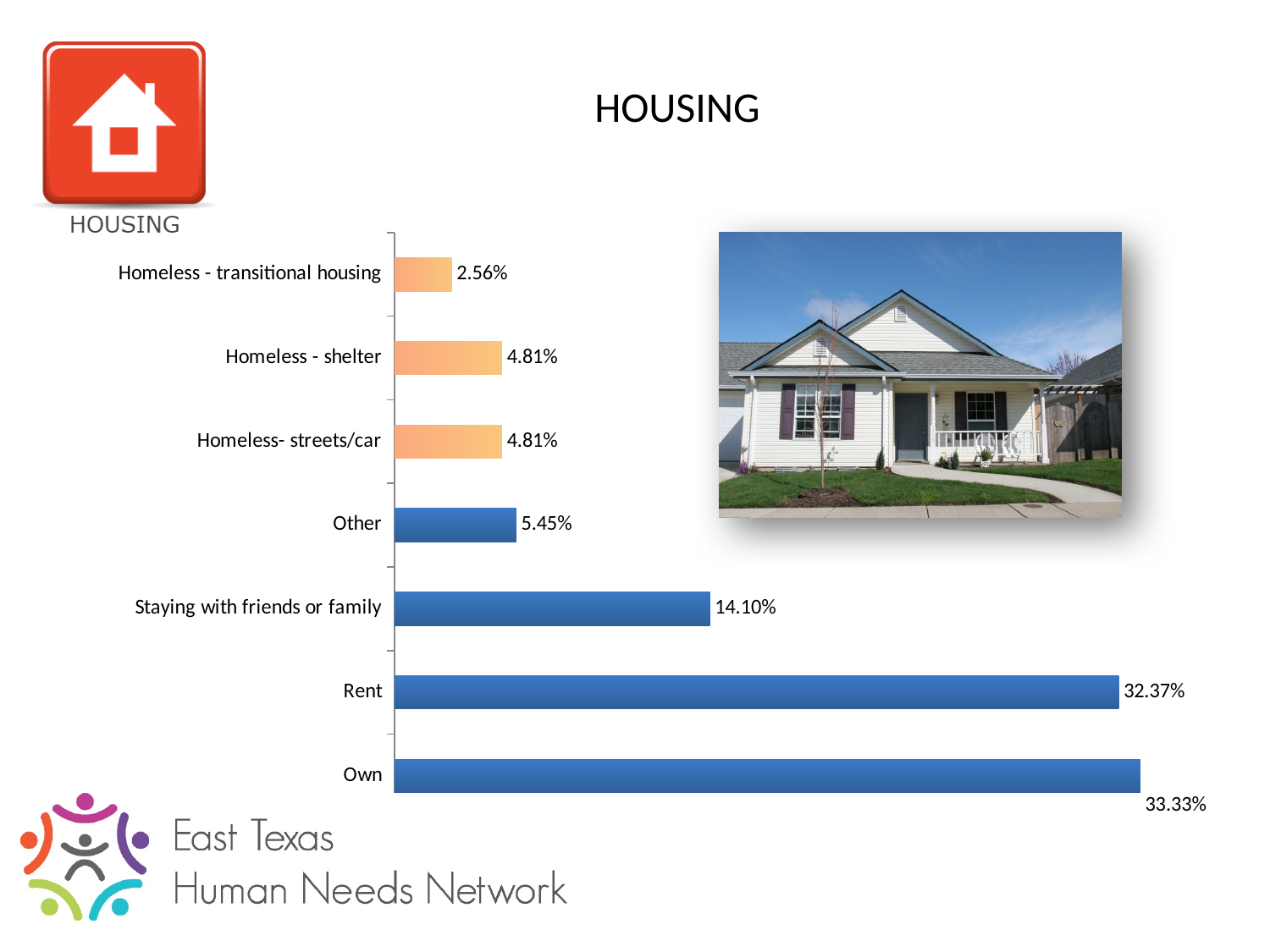
Which category has the lowest value? Homeless - transitional housing What is the value for Staying with friends or family? 14.10% Which category has the highest value? Own Which is larger, the value for Other or the value for Homeless - shelter? Other What percentage of respondents own their housing? 33.33% What is the value for Rent? 32.37% What is the difference between the values for Own and Rent? 0.96% What kind of chart is shown on the slide? Bar chart What is the title of the chart? HOUSING What is the difference between Staying with friends or family and Other? 8.65% What is the value for Homeless - transitional housing? 2.56% How many categories are shown in the chart? 7